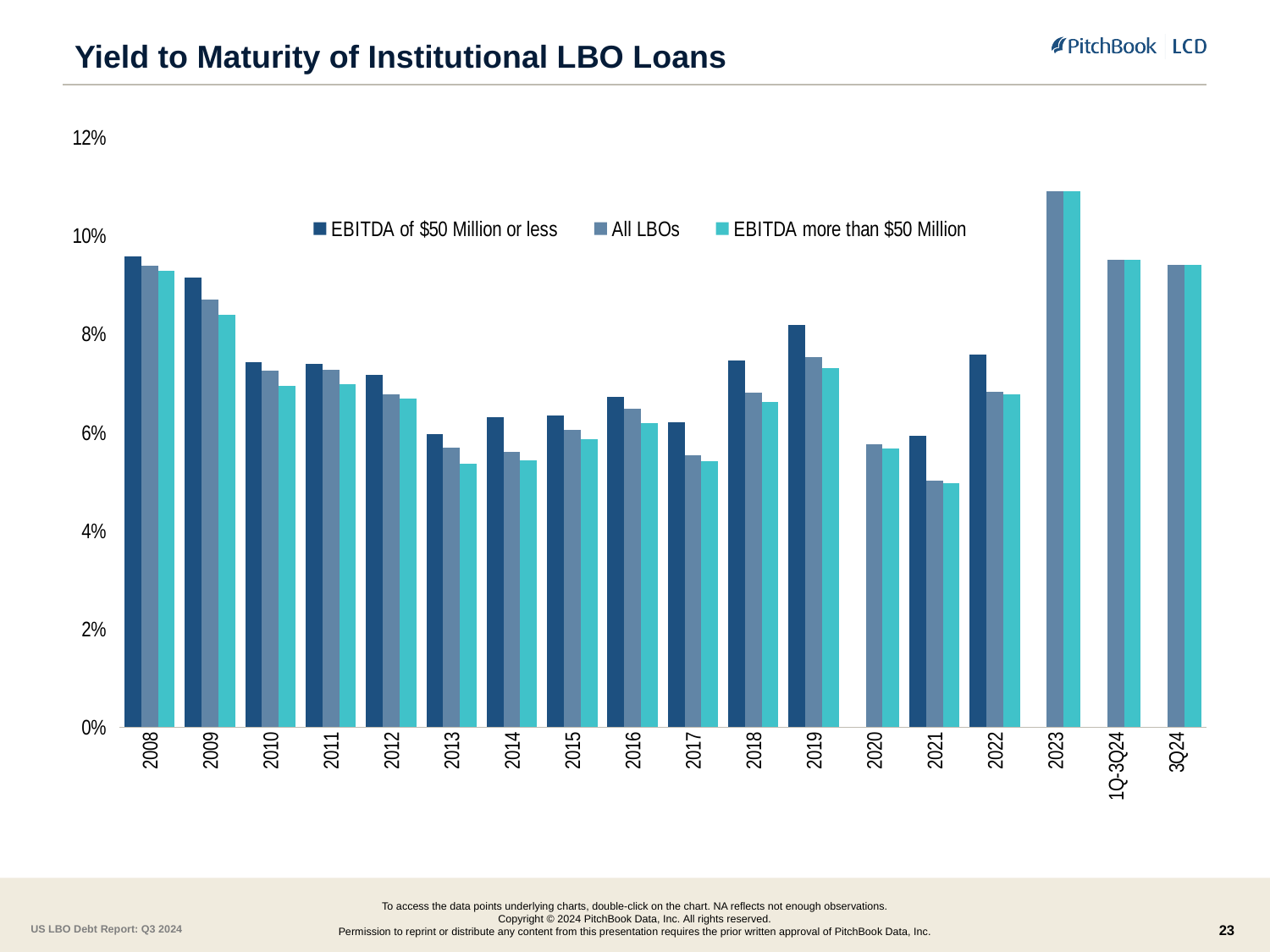
Is the value for EBITDA more than $50 Million in 2021 greater or less than 6%? less Which is larger for the All LBOs series: 2008 or 2013? 2008 Is the value for EBITDA of $50 Million or less in 2008 greater or less than 8%? greater Do the All LBOs values rise or fall from 2008 to 2013? fall How many categories are shown along the x axis? 18 What type of chart is shown on the slide? Bar chart What is the title of the chart? Yield to Maturity of Institutional LBO Loans How many series does the legend list? 3 Which category has the lowest value for the All LBOs series? 2021 Is the All LBOs value for 2020 greater or less than 6%? less Which category has the highest value for the All LBOs series? 2023